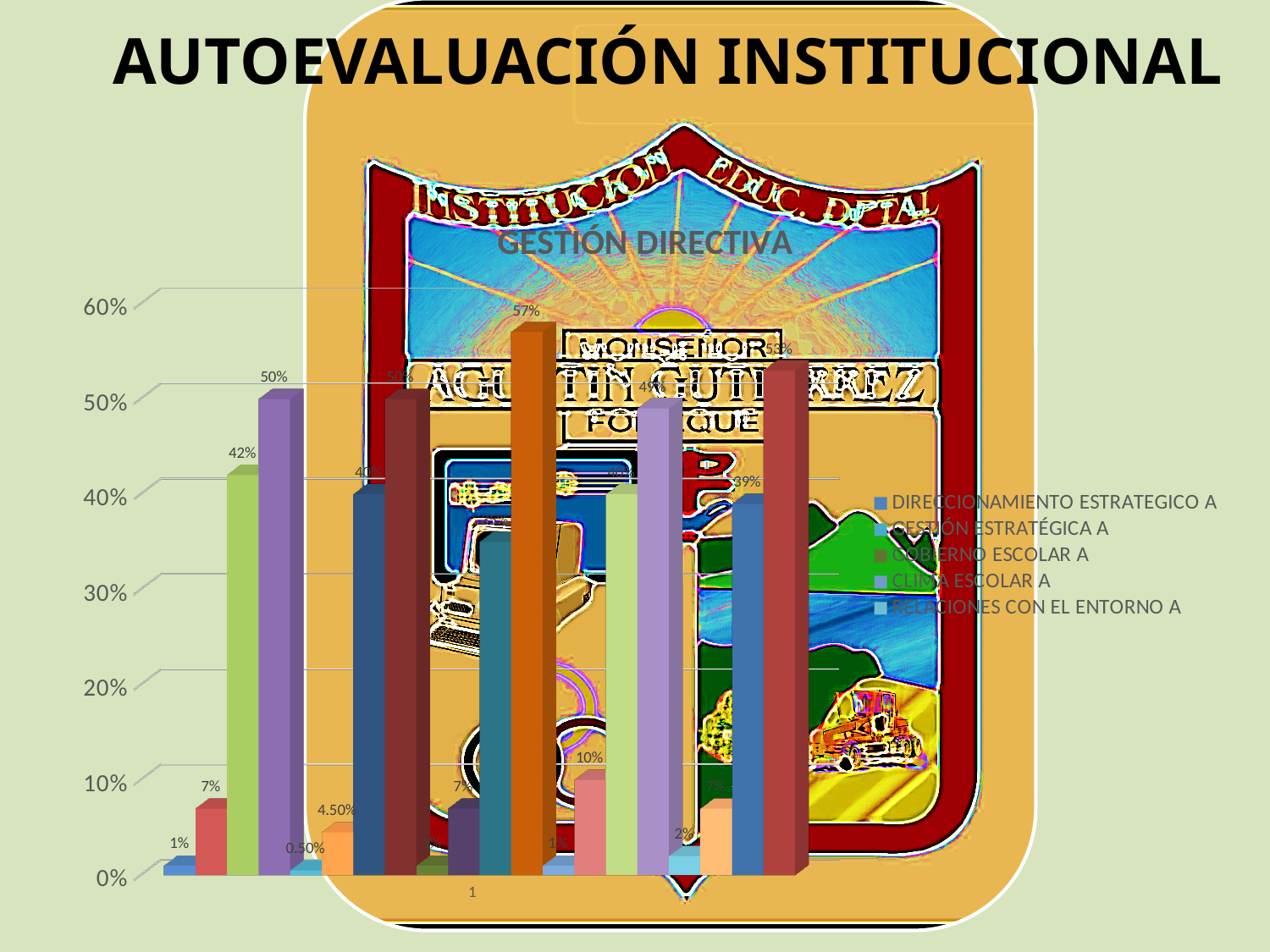
What is the title of the chart on the slide? GESTIÓN DIRECTIVA What is the difference between the highest data label (57%) and the lowest data label (0.50%) on the chart? 56.50% How many series does the chart's legend list? 5 What label appears on the chart's horizontal axis? 1 What is the highest value shown on the chart's vertical axis? 60% What is the highest data label printed on the chart? 57% What kind of chart is shown under the title GESTIÓN DIRECTIVA? bar chart Is the tallest bar on the chart greater or less than 50%? greater What is the lowest data label printed on the chart? 0.50% Which is larger on the chart: the bar labelled 57% or the bar labelled 53%? 57%